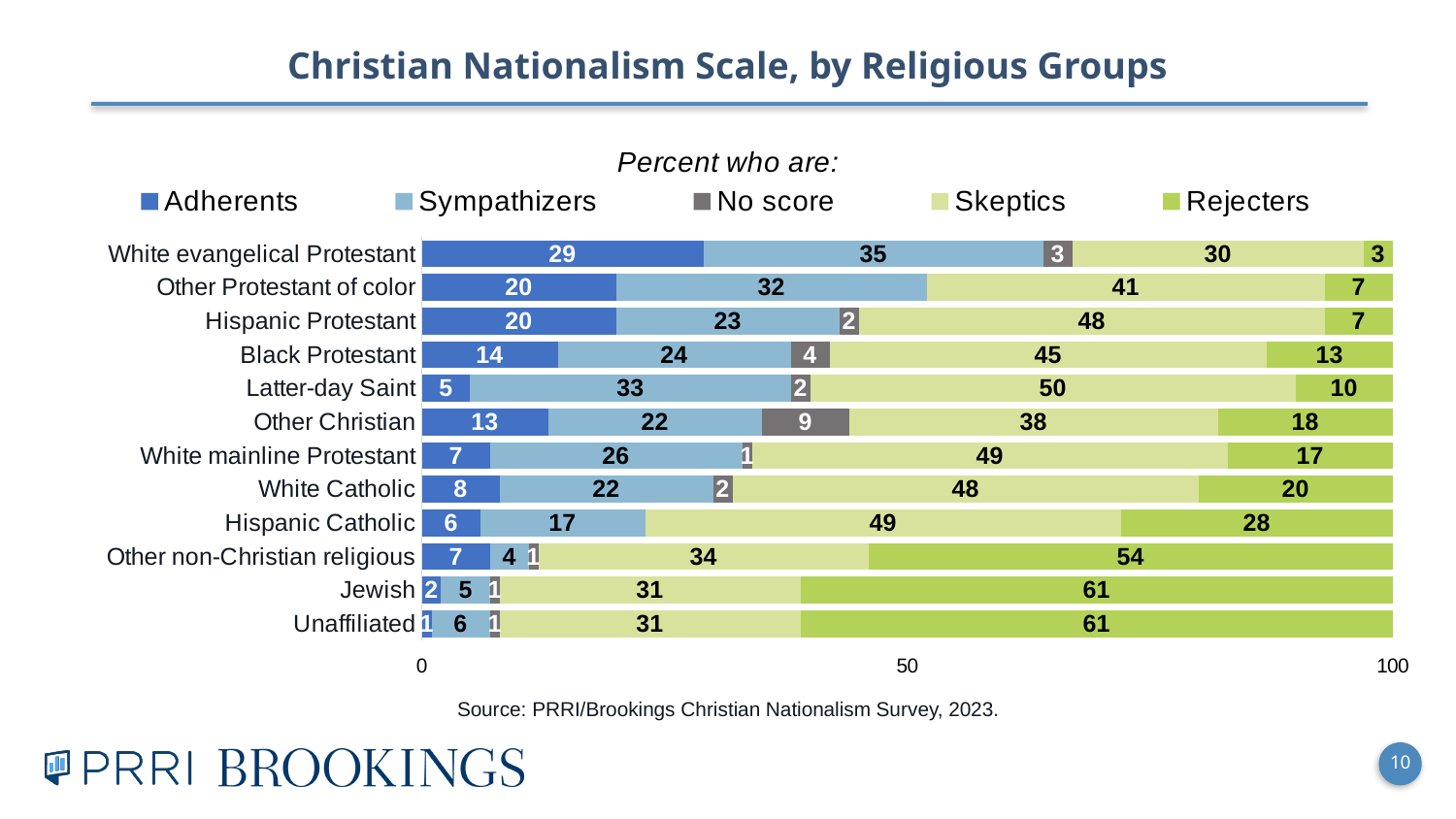
What is the source cited below the chart? PRRI/Brookings Christian Nationalism Survey, 2023 What is the difference between the Rejecters percentage for Hispanic Catholics and for White Catholics? 8 What percentage of Other Christian respondents have No score? 9 Which religious group has the highest percentage of Adherents? White evangelical Protestant Which religious group has the lowest percentage of Sympathizers? Other non-Christian religious Which group has a larger percentage of Skeptics, Black Protestant or Other Christian? Black Protestant What percentage of Other non-Christian religious respondents are Rejecters? 54 What kind of chart is shown on the slide? Stacked bar chart What percentage of Latter-day Saints are Skeptics? 50 How many religious groups are shown in the chart? 12 How many series does the legend list? 5 What percentage of White evangelical Protestants are Adherents? 29